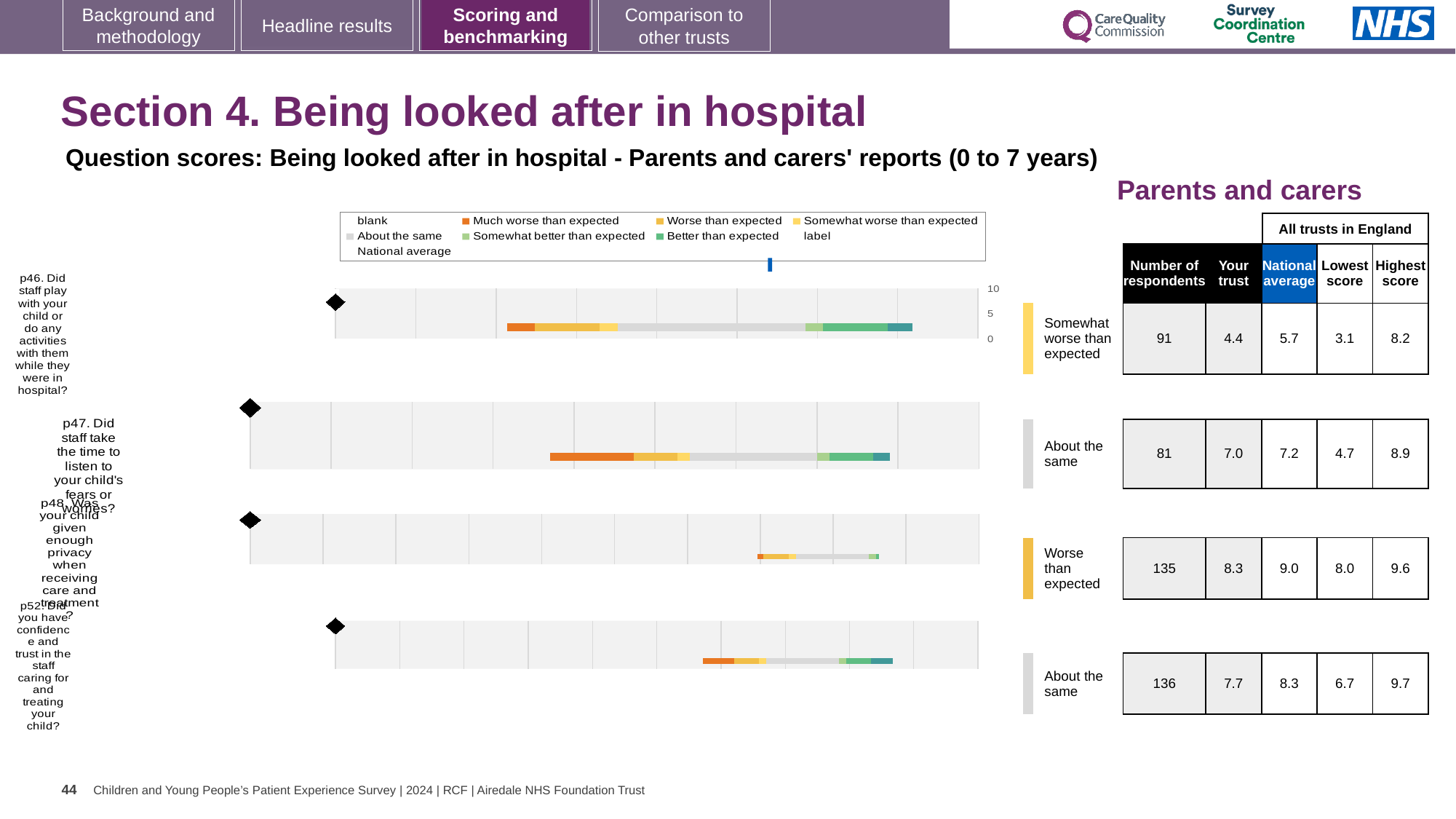
For question p46 (Did staff play with your child or do any activities with them while they were in hospital?), what is the 'Your trust' score shown? 4.4 What kind of chart is used to show the question scores on this slide? bar chart For question p46, what is the national average score shown? 5.7 What benchmark category label is shown next to the chart for question p48? Worse than expected Which question has the fewest respondents on this slide? p47 For question p47 (Did staff take the time to listen to your child's fears or worries?), how many respondents are shown? 81 For question p48 (Was your child given enough privacy when receiving care and treatment?), what is the highest score across all trusts in England? 9.6 For question p52 (Did you have confidence and trust in the staff caring for and treating your child?), what is the lowest score across all trusts in England? 6.7 For question p46, what is the difference between the national average and the 'Your trust' score? 1.3 For question p47, which is larger: the 'Your trust' score or the national average? National average How many questions (p46, p47, p48, p52) have a chart row on this slide? 4 Which question has the highest 'Your trust' score on this slide? p48